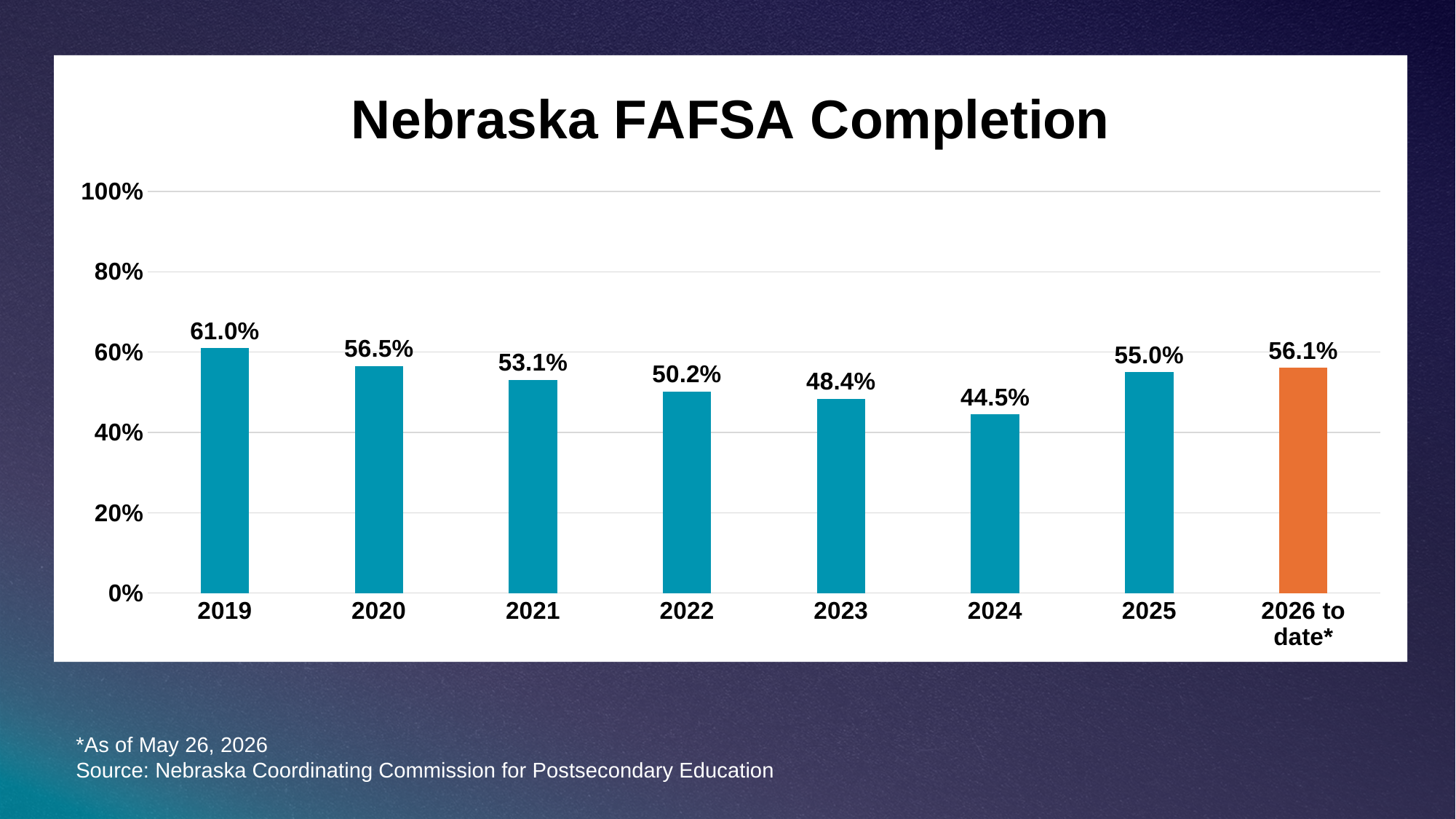
Which year has the highest FAFSA completion rate? 2019 How many years (categories) are shown on the chart? 8 What kind of chart is shown on the slide? Bar chart What is the FAFSA completion rate for 2019? 61.0% Which year has the lowest FAFSA completion rate? 2024 What is the FAFSA completion rate for 2024? 44.5% What is the difference between the 2025 and 2026 to date completion rates? 1.1% Is the value for 2021 greater or less than 60%? less Do the completion rates rise or fall from 2019 to 2024? Fall What is the difference between the 2019 and 2024 completion rates? 16.5% Which is larger, the completion rate for 2022 or for 2023? 2022 What is the FAFSA completion rate for 2026 to date? 56.1%